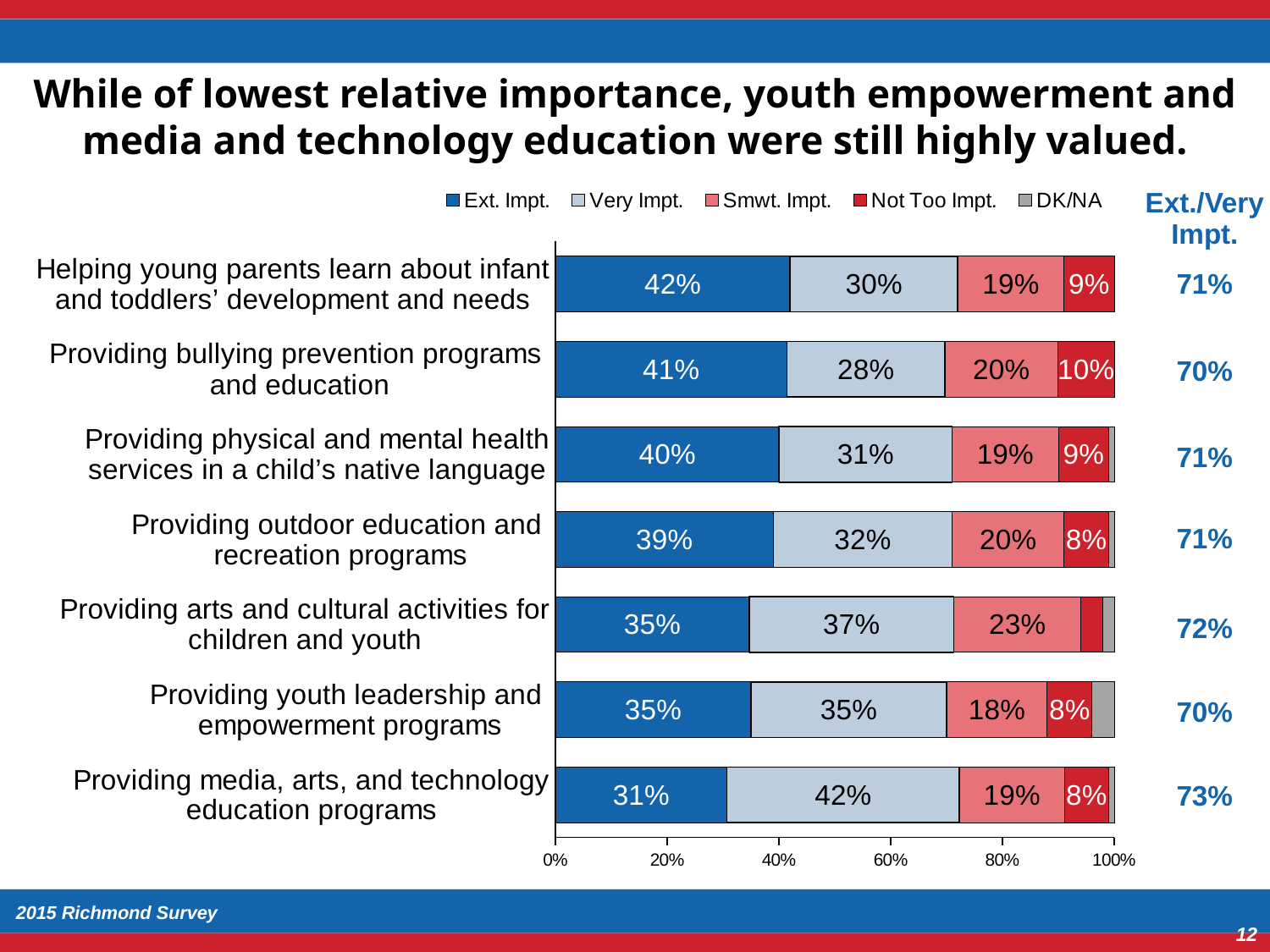
Which category has the highest Ext. Impt. value? Helping young parents learn about infant and toddlers' development and needs Which category has the lowest Ext. Impt. value? Providing media, arts, and technology education programs Which category has the highest Very Impt. value? Providing media, arts, and technology education programs How many series does the legend list? 5 How many categories (program types) are shown in the chart? 7 What percentage rated 'Providing media, arts, and technology education programs' as Ext. Impt.? 31% What is the Not Too Impt. value for 'Providing bullying prevention programs and education'? 10% Which has a larger Smwt. Impt. value: 'Providing arts and cultural activities for children and youth' or 'Providing youth leadership and empowerment programs'? Providing arts and cultural activities for children and youth What is the difference in Ext. Impt. between 'Providing bullying prevention programs and education' and 'Providing youth leadership and empowerment programs'? 6% What is the Ext./Very Impt. combined figure shown for 'Providing media, arts, and technology education programs'? 73% What is the Very Impt. value for 'Providing arts and cultural activities for children and youth'? 37% What kind of chart is shown on the slide? Stacked horizontal bar chart